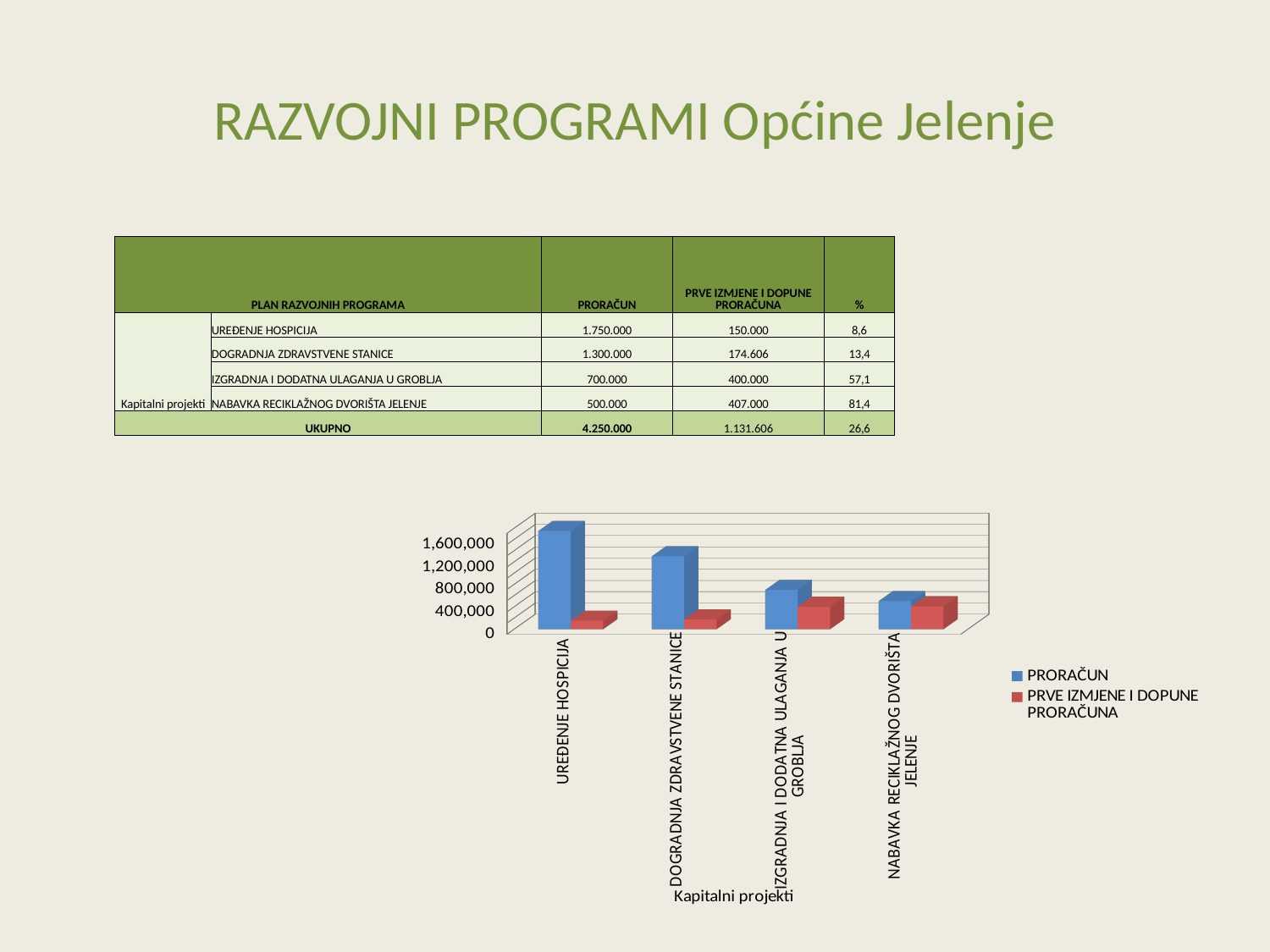
How many categories are plotted on the x axis of the chart? 4 Which category has the lowest PRORAČUN value in the chart? NABAVKA RECIKLAŽNOG DVORIŠTA JELENJE How many series does the chart legend list? 2 What is the x-axis title of the chart? Kapitalni projekti Is the PRVE IZMJENE I DOPUNE PRORAČUNA value for DOGRADNJA ZDRAVSTVENE STANICE greater or less than 400,000? less Is the PRORAČUN value for UREĐENJE HOSPICIJA greater or less than 1,600,000? greater What kind of chart is shown on the slide? bar chart Which is larger for IZGRADNJA I DODATNA ULAGANJA U GROBLJA: the PRORAČUN value or the PRVE IZMJENE I DOPUNE PRORAČUNA value? PRORAČUN According to the table, what is the PRVE IZMJENE I DOPUNE PRORAČUNA value for NABAVKA RECIKLAŽNOG DVORIŠTA JELENJE? 407.000 Which category has the highest PRORAČUN value in the chart? UREĐENJE HOSPICIJA According to the table, what is the PRORAČUN value for DOGRADNJA ZDRAVSTVENE STANICE? 1.300.000 Do the PRORAČUN values rise or fall moving left to right along the x axis? fall